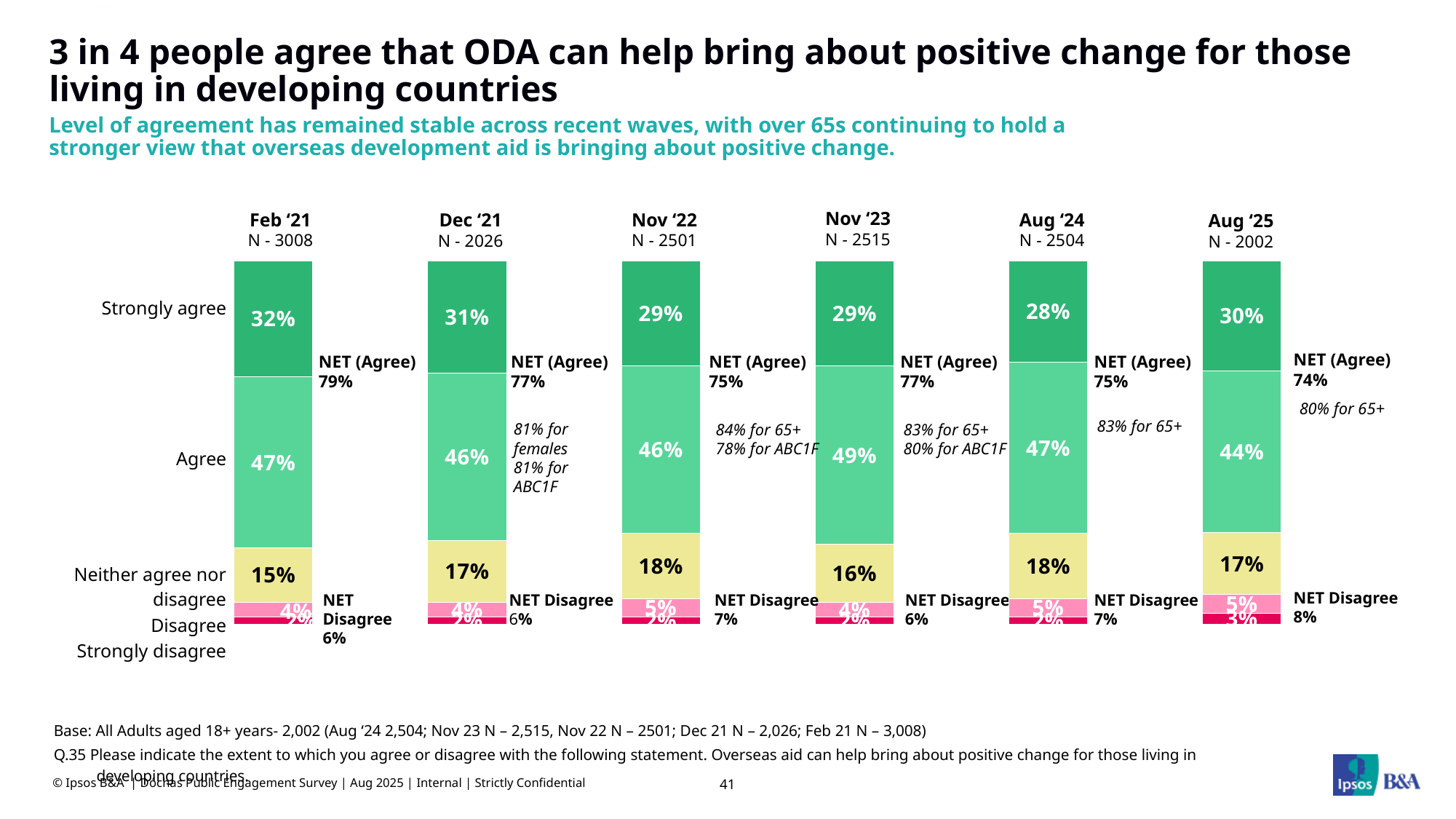
Which wave has the larger 'Agree' percentage, Nov '23 or Aug '25? Nov '23 What percentage of respondents strongly agreed in the Feb '21 wave? 32% What is the NET (Agree) figure for the Aug '25 wave? 74% Which wave has the lowest 'Strongly agree' percentage? Aug '24 What kind of chart is shown on the slide? Stacked bar chart What is the sample size (N) shown for the Aug '25 wave? N - 2002 What percentage of respondents chose 'Agree' in the Nov '23 wave? 49% Does the 'Strongly agree' percentage rise or fall from Feb '21 to Aug '24? Fall By how many percentage points did NET (Agree) fall from Feb '21 to Aug '25? 5 percentage points How many survey waves are shown in the chart? 6 What is the NET Disagree figure for the Aug '25 wave? 8% Which wave has the highest NET (Agree) figure? Feb '21